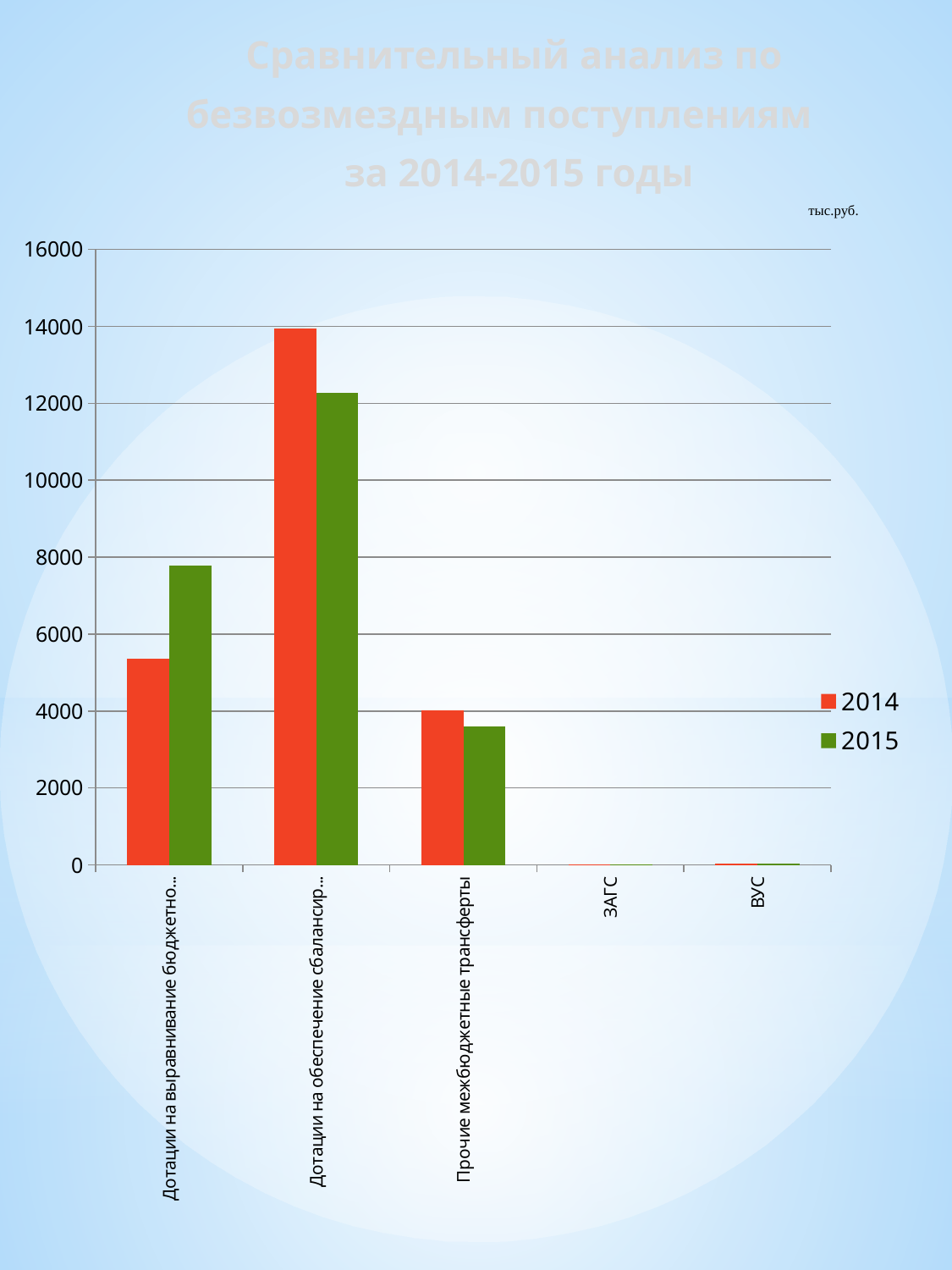
How many series does the legend list? 2 For 'Прочие межбюджетные трансферты', which year has the larger value, 2014 or 2015? 2014 Is the 2015 value for 'Дотации на выравнивание бюджетно...' greater or less than 6000? greater What kind of chart is shown on the slide? bar chart What unit label is shown above the chart? тыс.руб. Is the 2014 value for 'Прочие межбюджетные трансферты' greater or less than 2000? greater Is the 2014 value for 'Дотации на обеспечение сбалансир...' greater or less than 12000? greater Which category has the highest value for 2014? Дотации на обеспечение сбалансир... For 'Дотации на обеспечение сбалансир...', which year has the larger value, 2014 or 2015? 2014 For 'Дотации на выравнивание бюджетно...', which year has the larger value, 2014 or 2015? 2015 Which category has the highest value for 2015? Дотации на обеспечение сбалансир... How many categories are shown on the x axis? 5